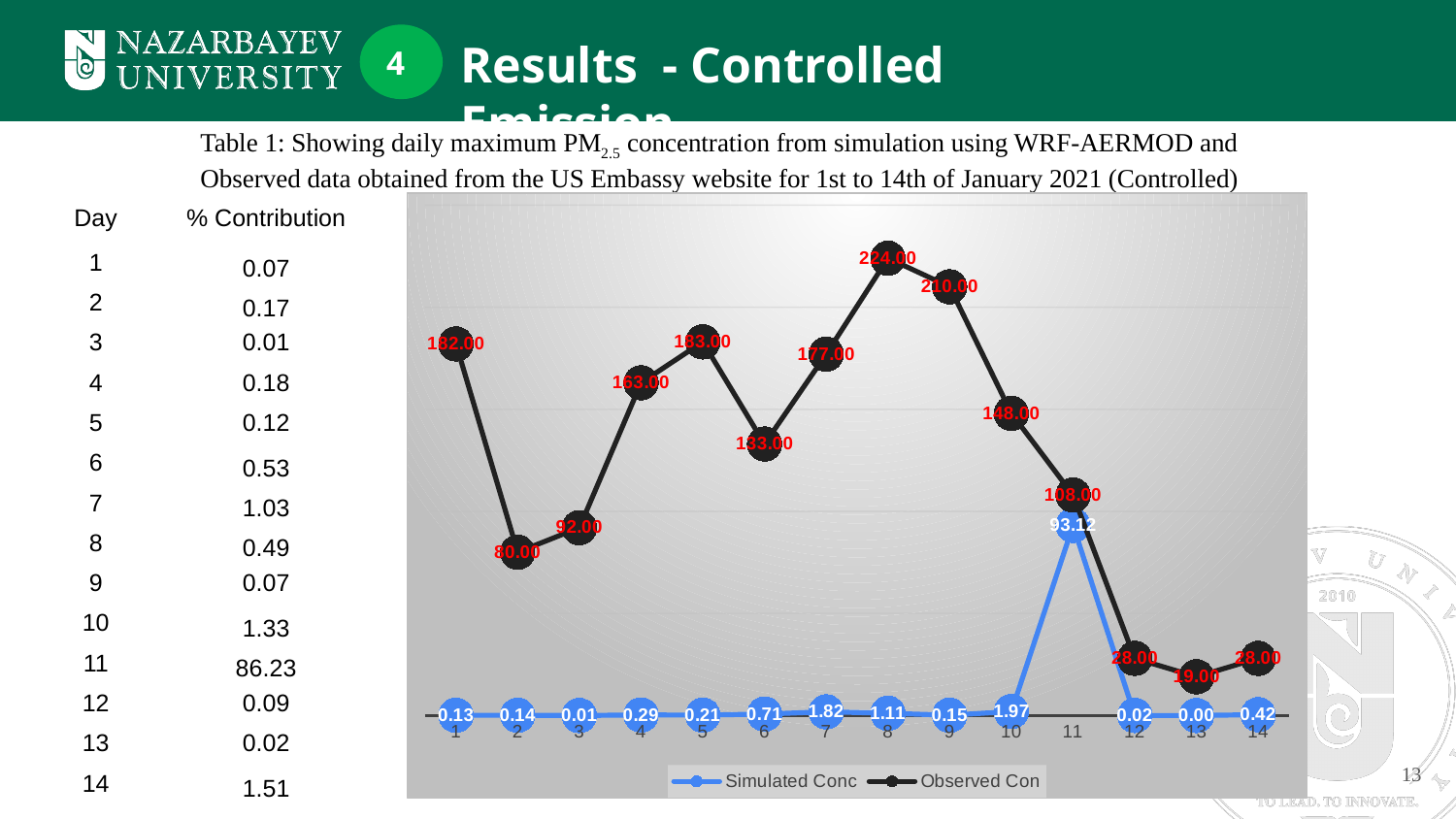
How many days are plotted along the x axis of the chart? 14 On which day is the Observed Con value highest? 8 On which day is the Simulated Conc value highest? 11 On which day is the Observed Con value lowest? 13 What is the Observed Con value on day 2? 80.00 What is the Simulated Conc value on day 11? 93.12 How many series does the chart legend list? 2 What is the difference between the Observed Con values on day 8 and day 9? 14.00 What type of chart is shown on the slide? line chart What is the Observed Con value on day 8? 224.00 Which is larger, the Observed Con value on day 2 or on day 3? day 3 What is the Simulated Conc value on day 10? 1.97